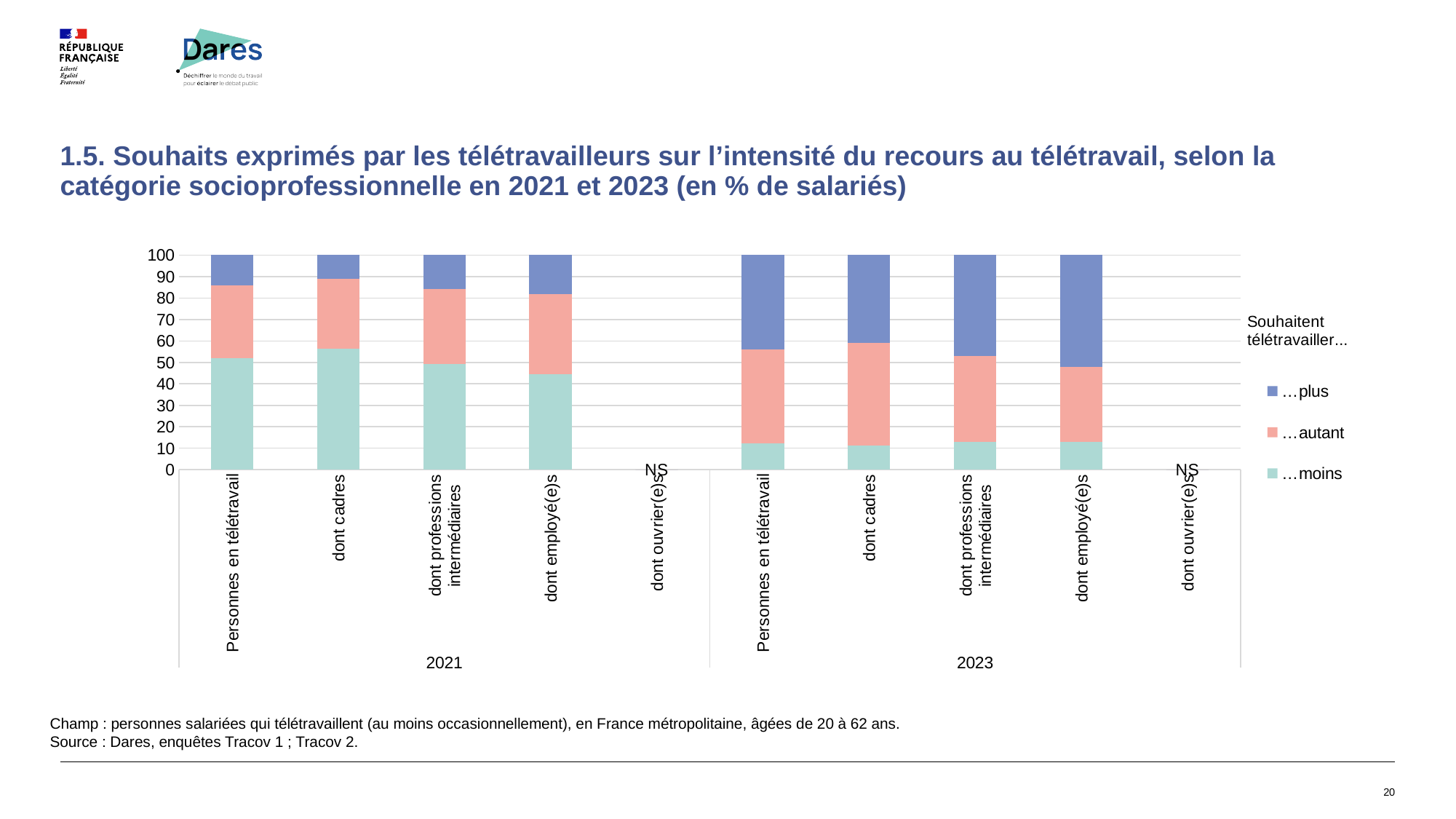
Does the "…moins" share for "Personnes en télétravail" rise or fall from 2021 to 2023? Fall Is the "…plus" value for "dont employé(e)s" in 2023 greater or less than 40? greater What kind of chart is shown on the slide? Stacked bar chart Is the "…moins" value for "dont cadres" in 2023 greater or less than 20? less Is the "…plus" value for "dont cadres" in 2021 greater or less than 20? less What is the total height of the stacked bar for "Personnes en télétravail" in 2023? 100 Which category is marked "NS" in both 2021 and 2023? dont ouvrier(e)s What is the title of the legend? Souhaitent télétravailler... How many series does the legend list? 3 Which is larger: the "…moins" value for "dont cadres" in 2021 or in 2023? 2021 How many categories are shown on the x axis for the year 2021? 5